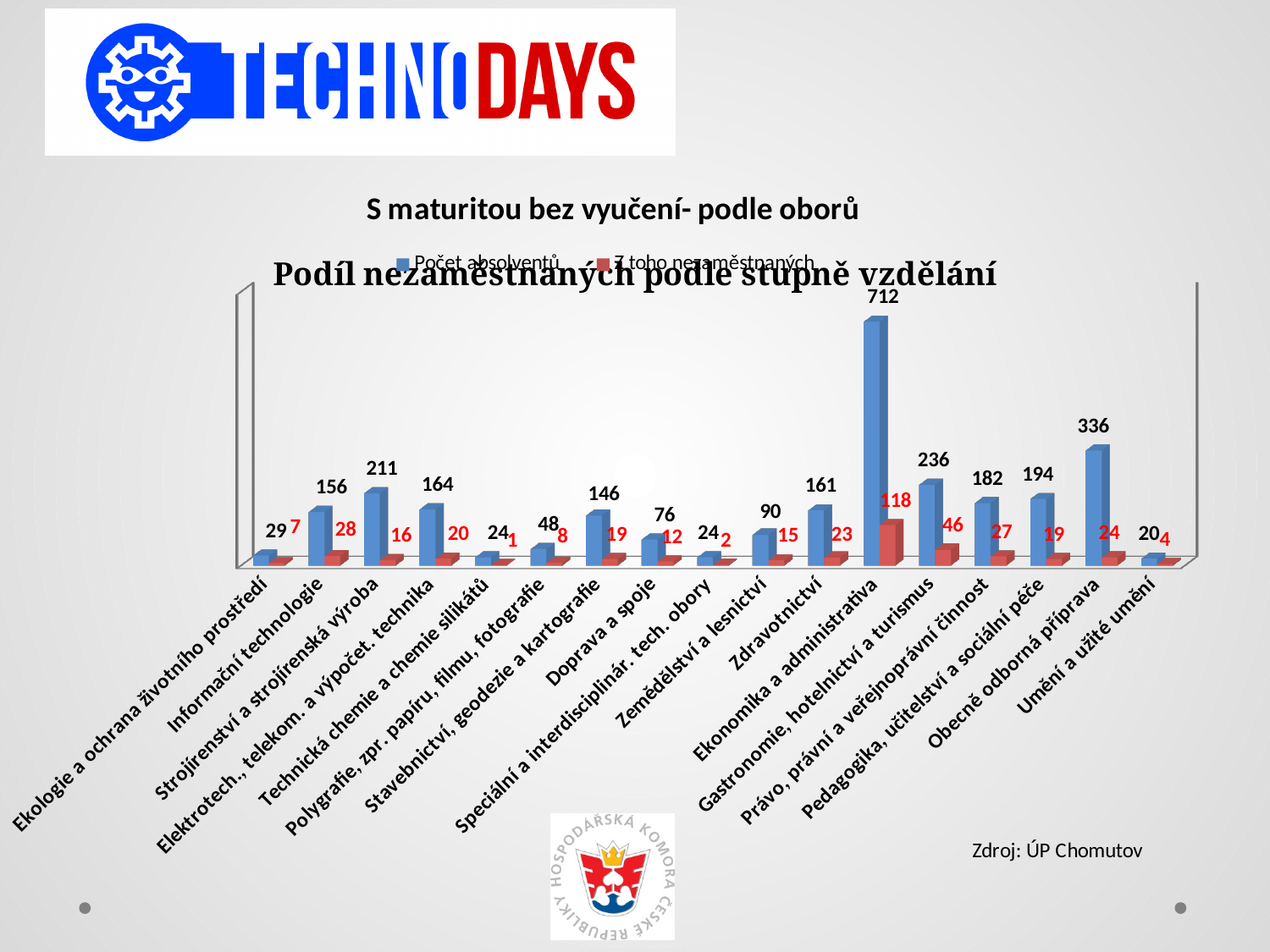
What is the difference between Počet absolventů and Z toho nezaměstnaných for Informační technologie? 128 What type of chart is shown on the slide? bar chart How many categories (fields of study) are shown on the x axis of the chart? 17 What is the value of Počet absolventů for Obecně odborná příprava? 336 What is the value of Počet absolventů for Ekonomika a administrativa? 712 Which category has the lowest value of Z toho nezaměstnaných? Technická chemie a chemie silikátů What is the value of Z toho nezaměstnaných for Gastronomie, hotelnictví a turismus? 46 Which has a larger value of Počet absolventů: Zdravotnictví or Strojírenství a strojírenská výroba? Strojírenství a strojírenská výroba Which category has the highest value of Počet absolventů? Ekonomika a administrativa What is the title of the chart? S maturitou bez vyučení- podle oborů What is the difference in Počet absolventů between Ekonomika a administrativa and Obecně odborná příprava? 376 How many series does the chart legend list? 2